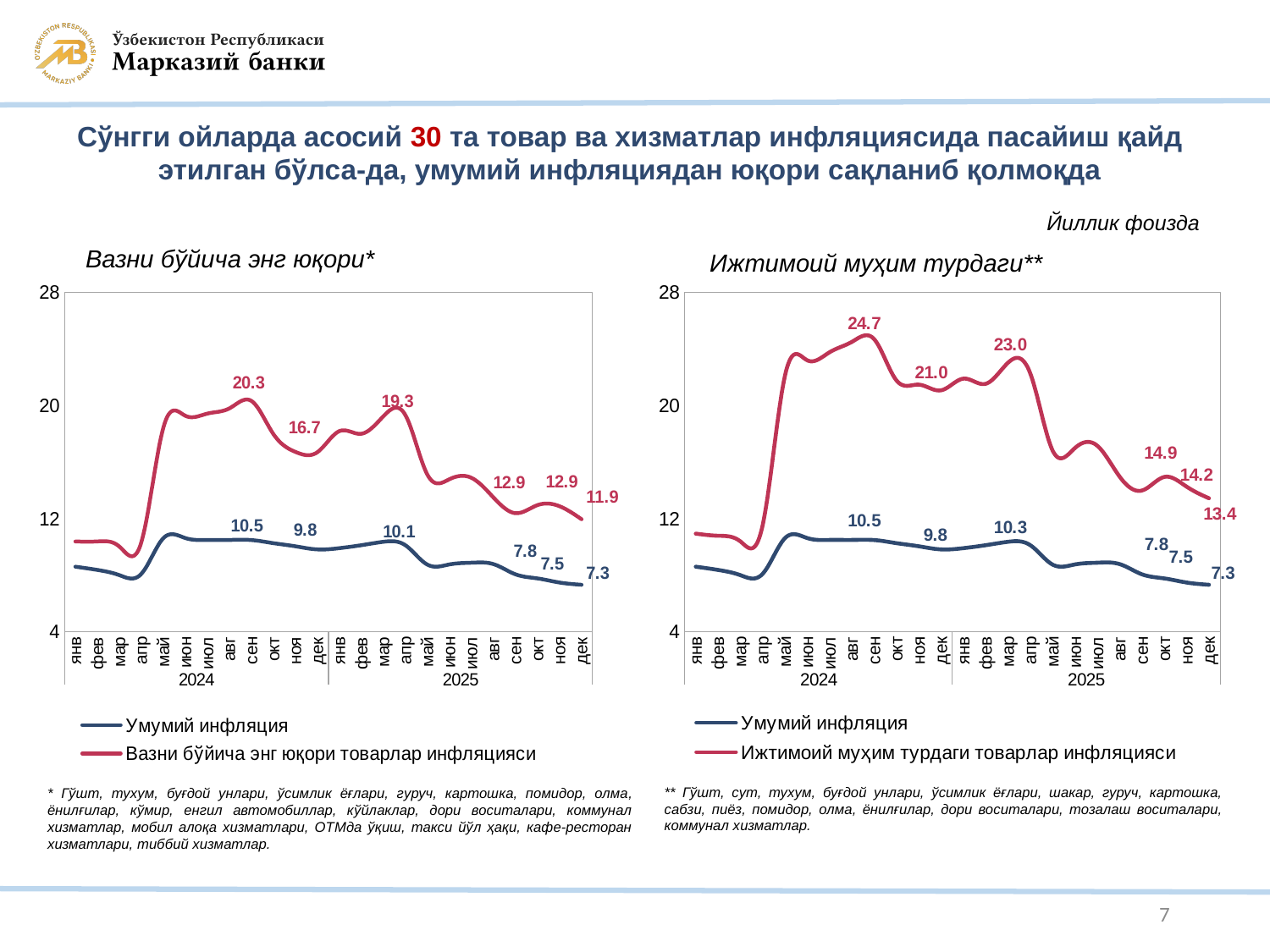
Comparing the final labelled values of the red series in the two charts, which is larger: 11.9 in the left chart or 13.4 in the right chart? 13.4 in the right chart How many series does the legend of the right chart "Ижтимоий муҳим турдаги**" list? 2 In the right chart "Ижтимоий муҳим турдаги**", what is the highest labelled value of the red series? 24.7 In the left chart "Вазни бўйича энг юқори*", does the blue series "Умумий инфляция" rise or fall from апр 2025 (10.1) to дек 2025 (7.3)? fall In the left chart "Вазни бўйича энг юқори*", what is the highest labelled value of the red series? 20.3 What kind of chart is the left chart titled "Вазни бўйича энг юқори*"? line chart In the left chart "Вазни бўйича энг юқори*", what is the last labelled value (дек 2025) of the red series "Вазни бўйича энг юқори товарлар инфляцияси"? 11.9 In the left chart "Вазни бўйича энг юқори*", what is the difference between the final labelled values of the red series (11.9) and the blue series "Умумий инфляция" (7.3)? 4.6 In the right chart "Ижтимоий муҳим турдаги**", what is the last labelled value (дек 2025) of the red series "Ижтимоий муҳим турдаги товарлар инфляцияси"? 13.4 In the right chart "Ижтимоий муҳим турдаги**", what is the difference between the labelled peak 24.7 and the final value 13.4 of the red series? 11.3 What is the unit note shown above the charts on the slide? Йиллик фоизда In the right chart "Ижтимоий муҳим турдаги**", is the value of the red series in сен 2024 greater or less than 20? greater